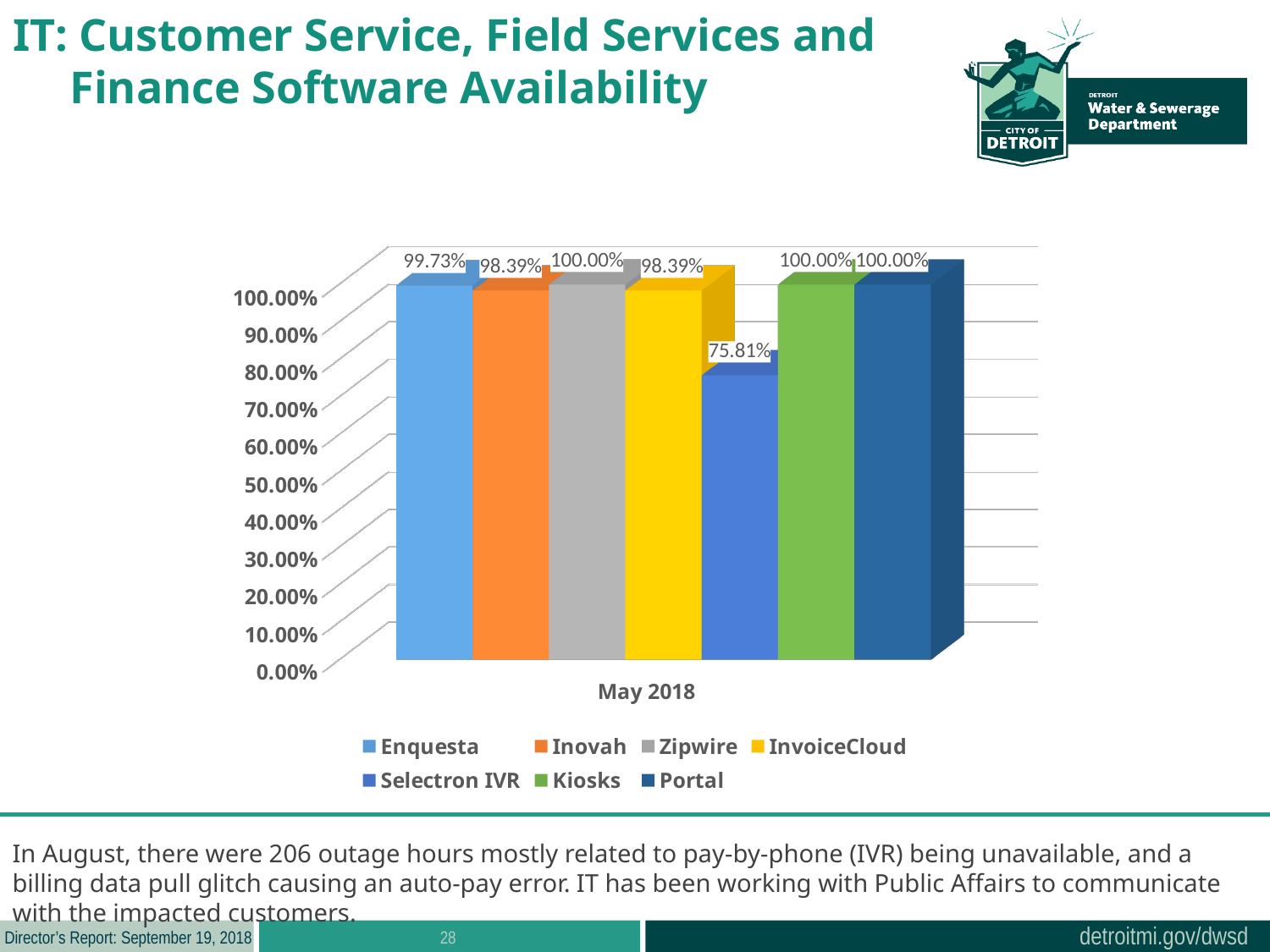
What is the availability value for Enquesta? 99.73% What is the category label shown on the x axis of the chart? May 2018 How many series show a value of exactly 100.00%? 3 Is the value for Selectron IVR greater or less than 80.00%? less Which is larger, the value for Enquesta or the value for Inovah? Enquesta What kind of chart is shown on the slide? bar chart What is the availability value for Inovah? 98.39% What is the availability value for Kiosks? 100.00% How many series does the legend list? 7 Which series has the lowest availability value? Selectron IVR What is the difference between the Enquesta value and the Selectron IVR value? 23.92% What is the availability value for Selectron IVR? 75.81%